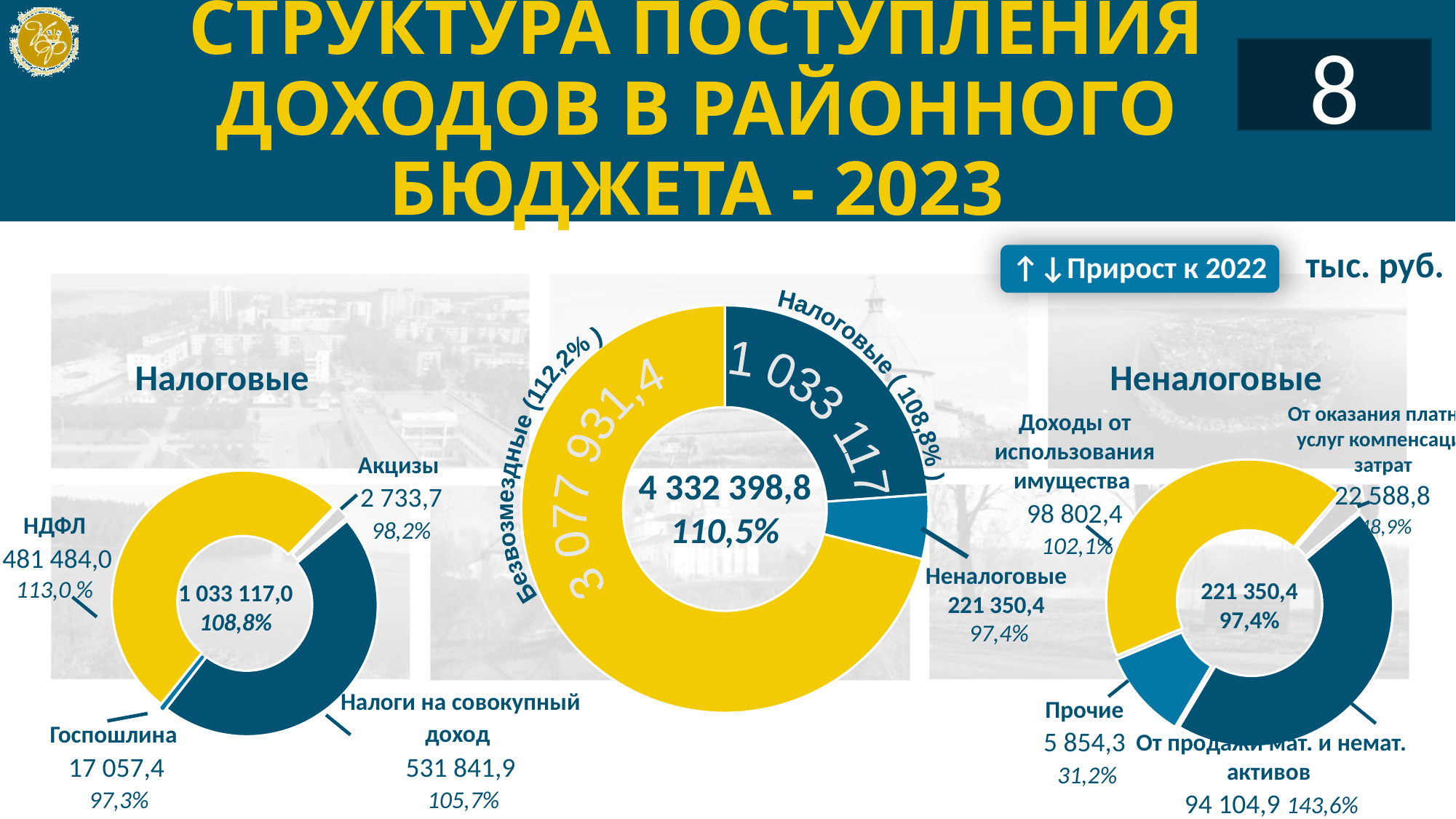
In the central chart, which segment is the largest? Безвозмездные In the left chart (Налоговые), what is the value for НДФЛ? 481 484,0 In the central chart, what growth percentage relative to 2022 is shown for Налоговые? 108,8% In the central chart, what total value is shown in the middle of the donut? 4 332 398,8 In the central chart, which segment is the smallest? Неналоговые In the left chart (Налоговые), what is the difference between Налоги на совокупный доход and НДФЛ? 50 357,9 How many categories are shown in the left chart (Налоговые)? 4 What kind of chart is used on this slide? Pie (donut) chart In the right chart (Неналоговые), what growth percentage is shown for Прочие? 31,2% In the left chart (Налоговые), which category has the smallest value? Акцизы In the central chart, what is the value for Безвозмездные? 3 077 931,4 In the right chart (Неналоговые), what is the value for От продажи мат. и немат. активов? 94 104,9